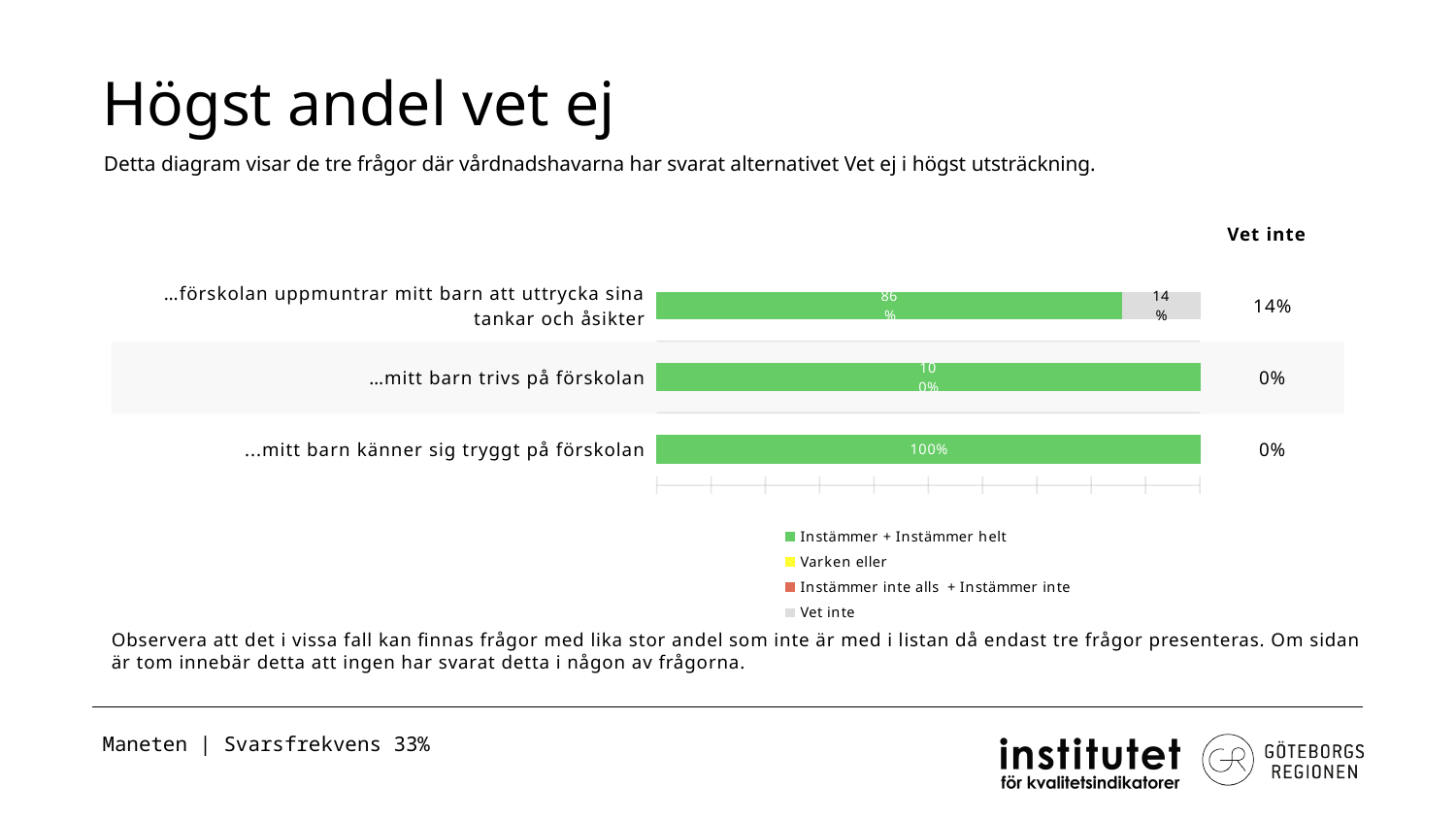
How many categories (questions) are plotted in the chart? 3 What kind of chart is shown on the slide? stacked bar chart What is the 'Instämmer + Instämmer helt' value for '…förskolan uppmuntrar mitt barn att uttrycka sina tankar och åsikter'? 86% What is the title of the slide containing the chart? Högst andel vet ej What is the total of the stacked bar for '…förskolan uppmuntrar mitt barn att uttrycka sina tankar och åsikter'? 100% Which category has the highest 'Vet inte' share? …förskolan uppmuntrar mitt barn att uttrycka sina tankar och åsikter Which is larger: the 'Instämmer + Instämmer helt' value for '…mitt barn känner sig tryggt på förskolan' or for '…förskolan uppmuntrar mitt barn att uttrycka sina tankar och åsikter'? …mitt barn känner sig tryggt på förskolan What is the 'Vet inte' value for '…förskolan uppmuntrar mitt barn att uttrycka sina tankar och åsikter'? 14% How many series does the legend list? 4 What is the difference between the 'Instämmer + Instämmer helt' value for '…mitt barn trivs på förskolan' and for '…förskolan uppmuntrar mitt barn att uttrycka sina tankar och åsikter'? 14% What is the 'Instämmer + Instämmer helt' value for '…mitt barn känner sig tryggt på förskolan'? 100% What is the 'Vet inte' value for '…mitt barn trivs på förskolan'? 0%